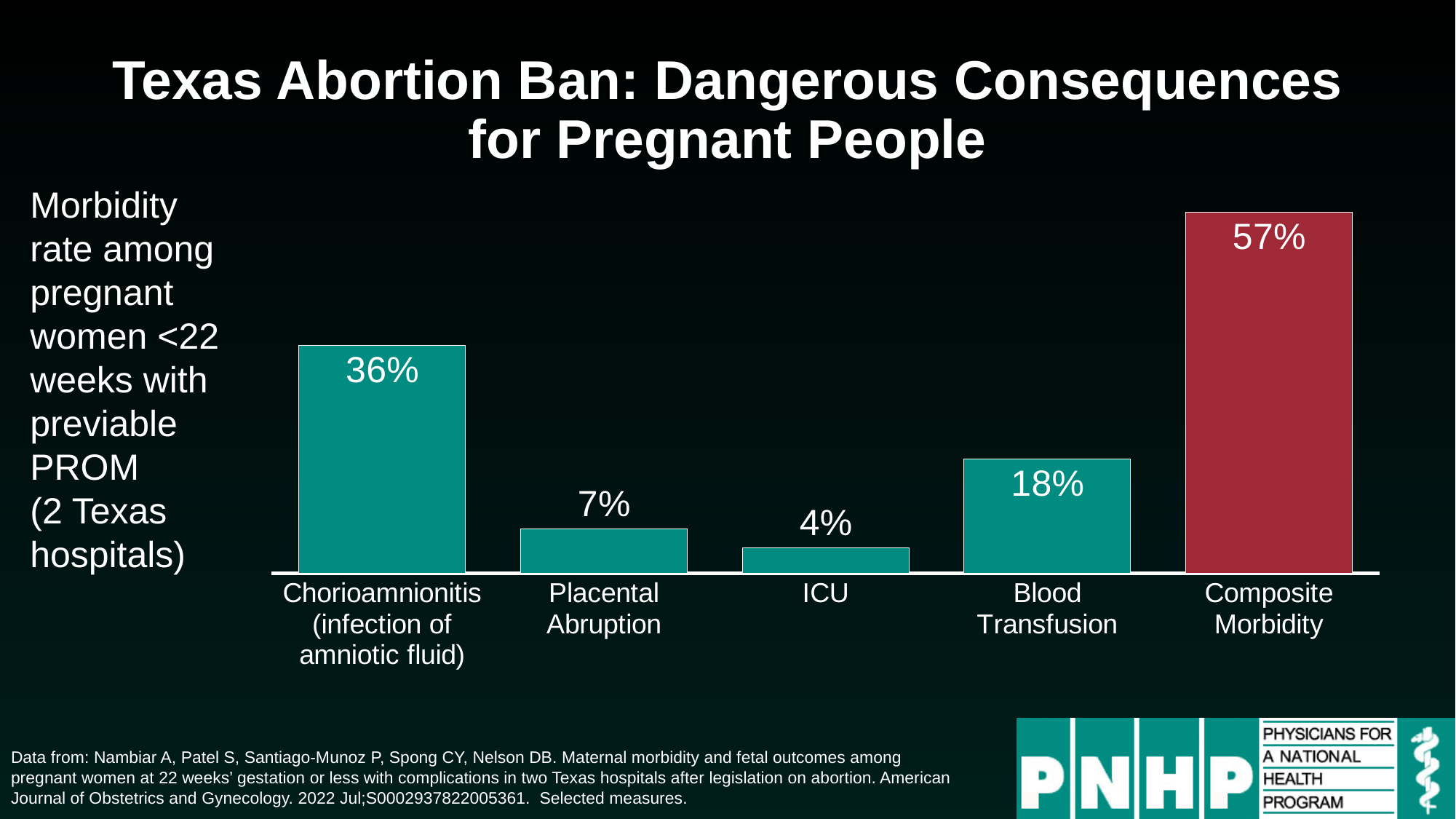
What is the value for Composite Morbidity? 57% What is the morbidity rate for Placental Abruption? 7% Which category has the highest morbidity rate? Composite Morbidity Which category has the lowest morbidity rate? ICU How many categories are shown in the chart? 5 What kind of chart is shown on the slide? Bar chart Which bar is shown in a different colour (red) from the others? Composite Morbidity What is the morbidity rate for ICU? 4% What is the morbidity rate for Blood Transfusion? 18% What is the difference between the Composite Morbidity rate and the Chorioamnionitis rate? 21% What is the morbidity rate for Chorioamnionitis? 36% Which is larger, the rate for Blood Transfusion or the rate for Placental Abruption? Blood Transfusion